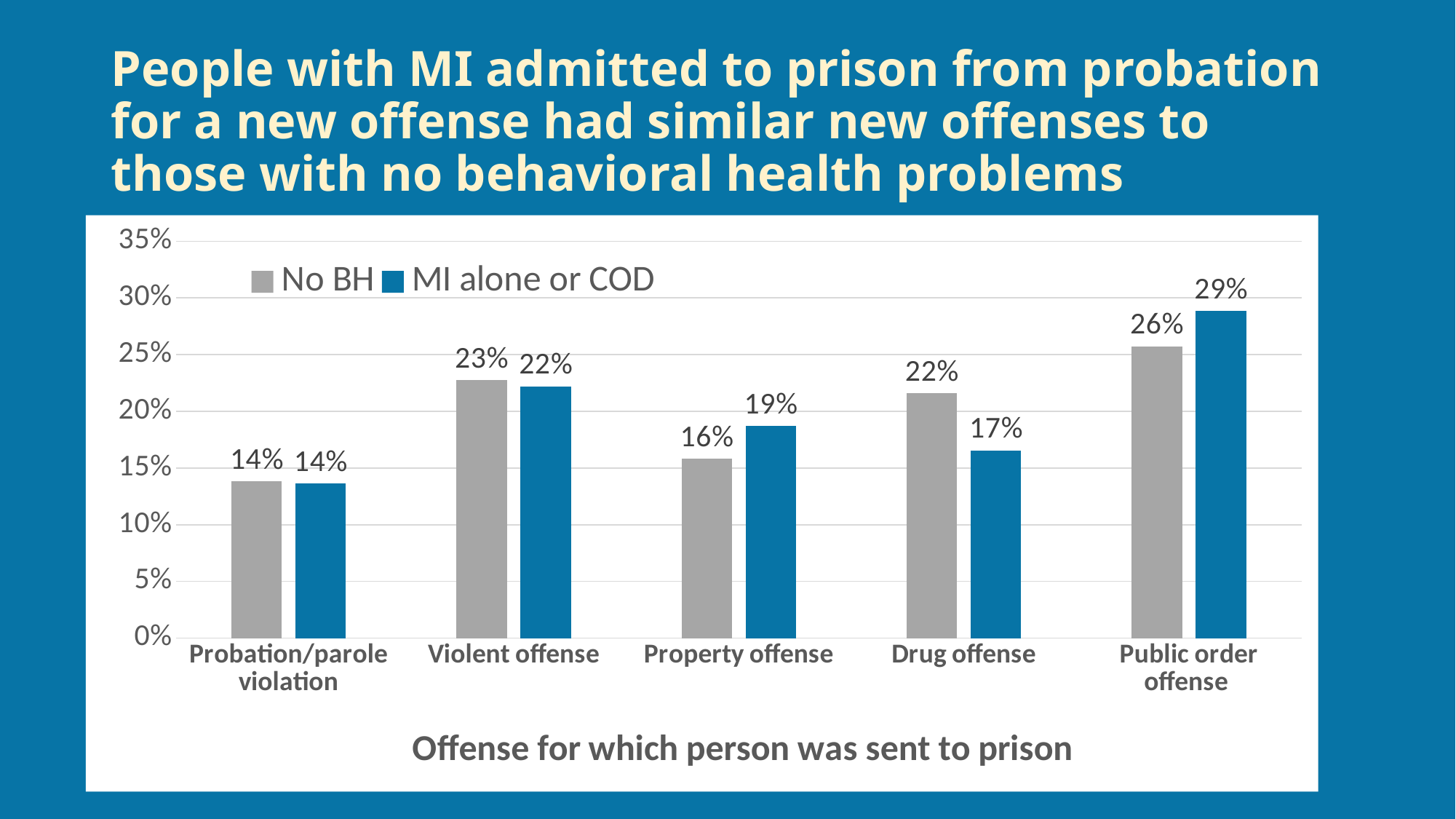
For Property offense, which series has the larger value, No BH or MI alone or COD? MI alone or COD How many offense categories are shown on the x axis? 5 What kind of chart is shown on the slide? Bar chart What is the difference between the No BH and MI alone or COD values for Drug offense? 5% What is the value for MI alone or COD for Property offense? 19% What is the value for No BH for Drug offense? 22% Which offense category has the highest value for MI alone or COD? Public order offense What is the value for No BH for Violent offense? 23% What is the value for MI alone or COD for Public order offense? 29% Which offense category has the lowest value for No BH? Probation/parole violation How many series does the legend list? 2 What is the x-axis title of the chart? Offense for which person was sent to prison